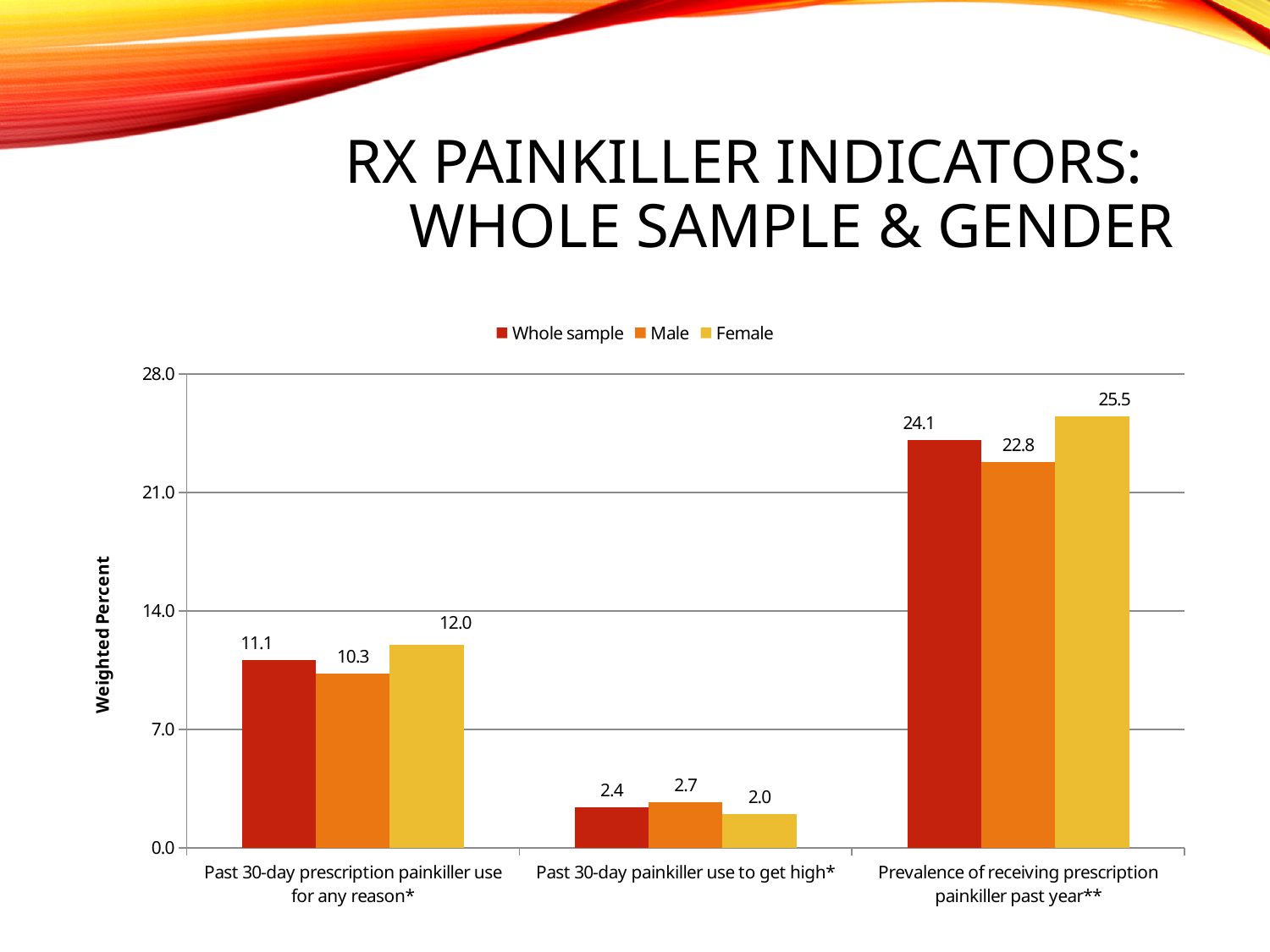
What is the Whole sample value for 'Past 30-day prescription painkiller use for any reason*'? 11.1 What is the Male value for 'Past 30-day painkiller use to get high*'? 2.7 What is the label of the y axis? Weighted Percent Which category has the lowest Female value? Past 30-day painkiller use to get high* What kind of chart is shown on the slide? Bar chart How many series does the legend list? 3 Which category has the highest Whole sample value? Prevalence of receiving prescription painkiller past year** Is the Whole sample value for 'Prevalence of receiving prescription painkiller past year**' greater or less than 21.0? greater For 'Past 30-day painkiller use to get high*', which is larger: the Male value or the Female value? Male How many categories are shown on the x axis? 3 What is the difference between the Female and Male values for 'Prevalence of receiving prescription painkiller past year**'? 2.7 What is the Female value for 'Prevalence of receiving prescription painkiller past year**'? 25.5